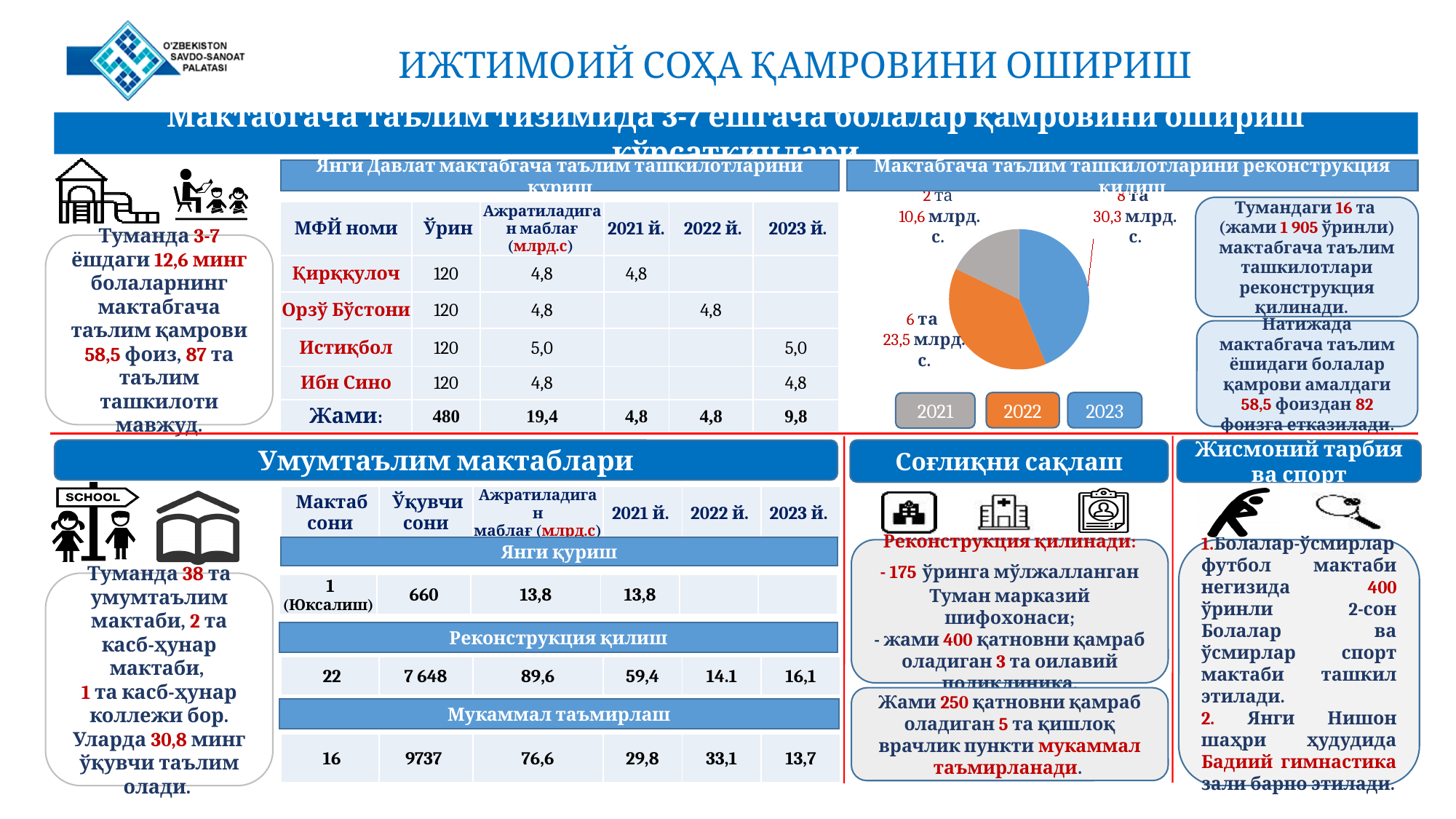
What is the total of the three amounts labelled on the pie chart (10,6 + 23,5 + 30,3)? 64,4 млрд. с. In the pie chart, what amount in млрд. с. is labelled for the slice with 2 та? 10,6 млрд. с. Which year's slice is the largest in the pie chart? 2023 How many entries does the legend of the pie chart list? 3 In the pie chart, what is the difference between the 30,3 млрд. с. slice and the 10,6 млрд. с. slice? 19,7 млрд. с. Which years are listed in the legend of the pie chart? 2021, 2022, 2023 In the pie chart, which is larger: the 2022 slice or the 2021 slice? 2022 In the pie chart, how many organisations (та) are labelled for the slice with 23,5 млрд. с.? 6 та Which year's slice is the smallest in the pie chart? 2021 What kind of chart is shown under the heading "Мактабгача таълим ташкилотларини реконструкция қилиш"? pie chart How many slices does the pie chart have? 3 In the pie chart, what amount in млрд. с. is labelled for the slice with 8 та? 30,3 млрд. с.